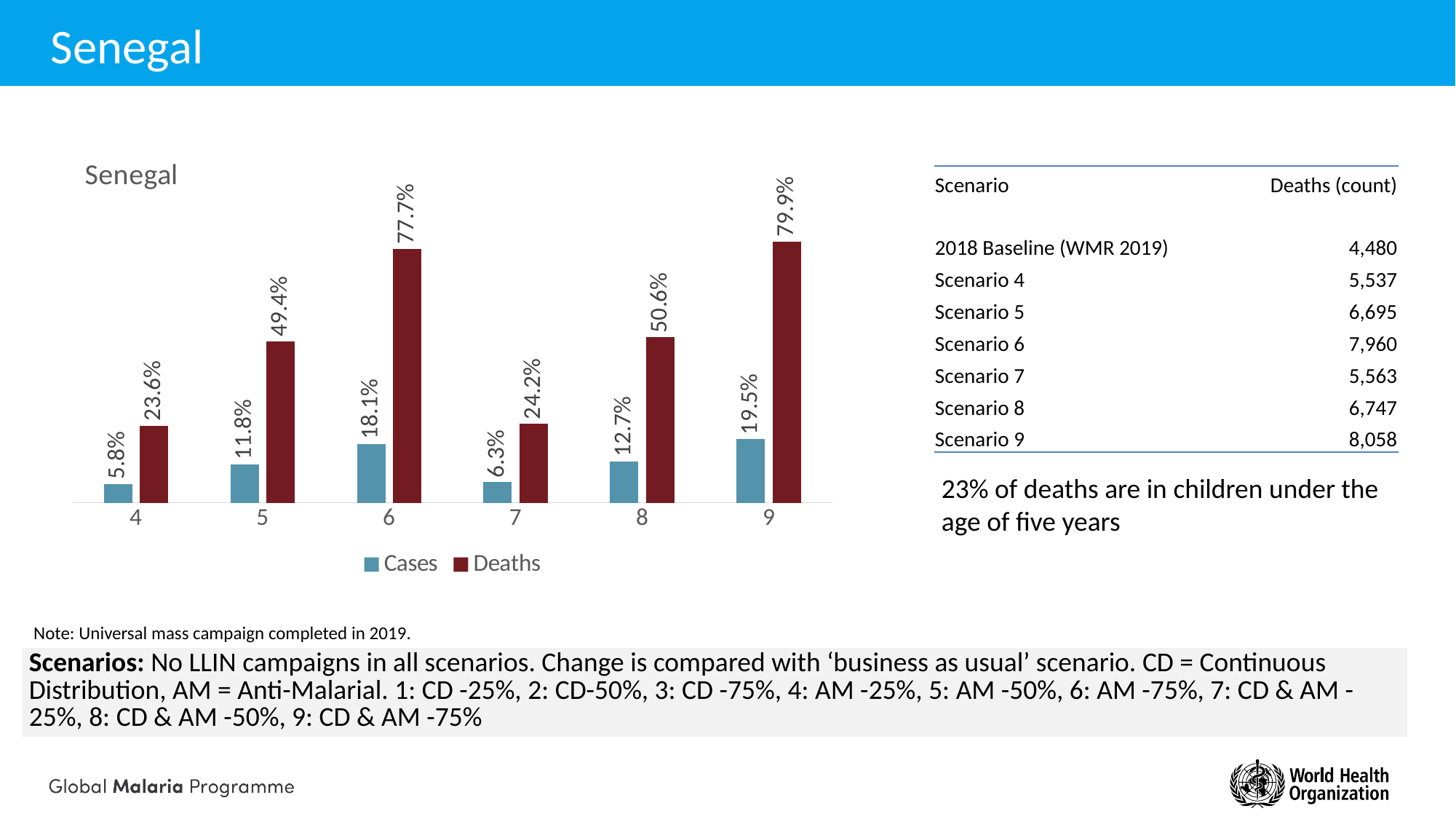
Which is larger, the Deaths value for scenario 5 or the Deaths value for scenario 7? Scenario 5 How many scenarios are shown on the x axis of the chart? 6 Which scenario has the lowest Cases value? 4 What is the Cases value for scenario 7? 6.3% What is the Deaths value for scenario 9? 79.9% What is the Deaths value for scenario 4? 23.6% What is the Cases value for scenario 6? 18.1% What is the difference between the Deaths value and the Cases value for scenario 8? 37.9% What kind of chart is shown on the slide? Bar chart Which scenario has the highest Deaths value? 9 How many series does the chart legend list? 2 What are the two series named in the chart legend? Cases and Deaths